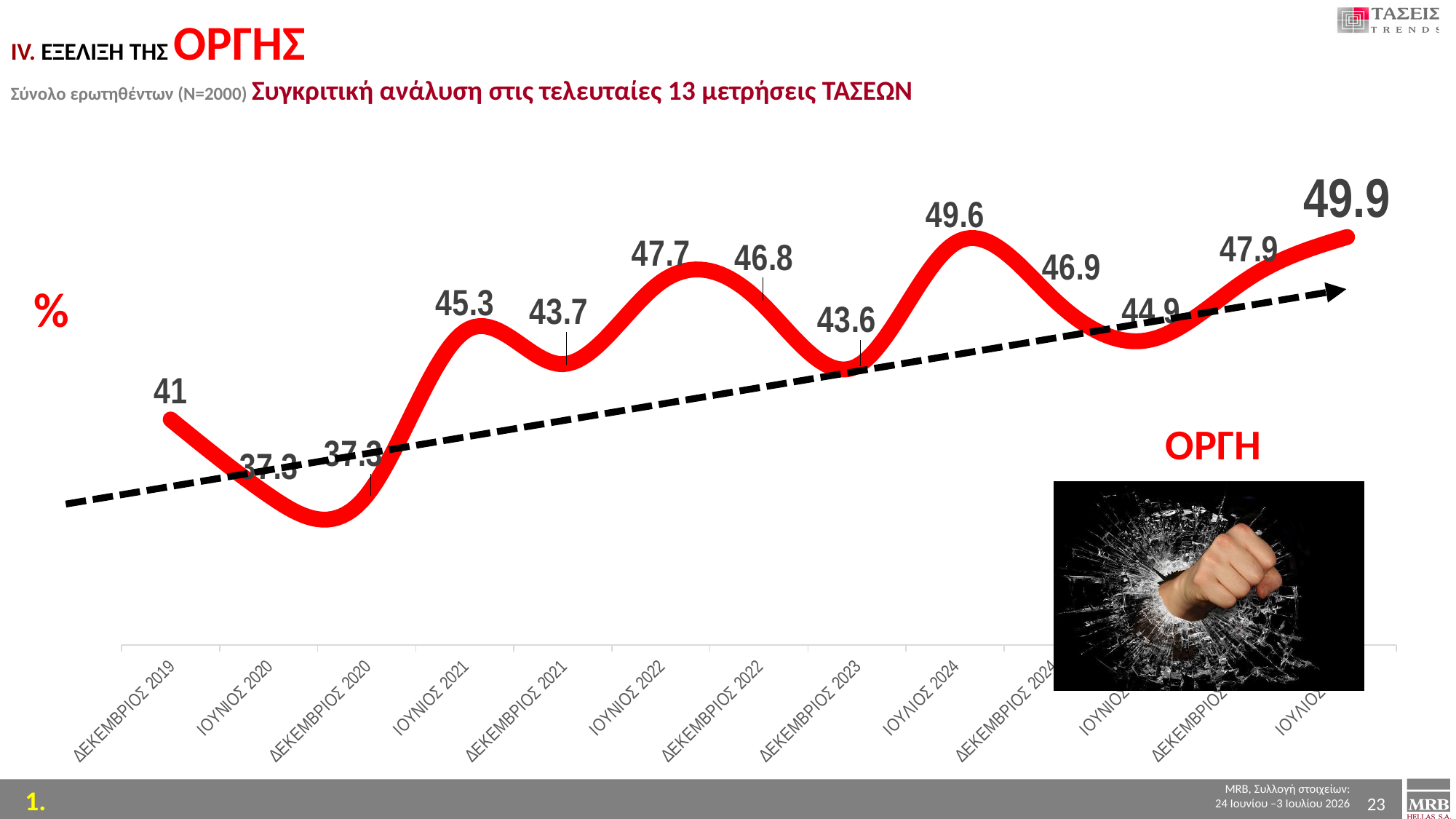
What is the value for ΙΟΥΛΙΟΣ 2024? 49.6 What is the value for ΔΕΚΕΜΒΡΙΟΣ 2023? 43.6 What is the highest value shown on the line? 49.9 How many measurement points are plotted on the chart? 13 What is the value for ΙΟΥΝΙΟΣ 2022? 47.7 What is the value for ΔΕΚΕΜΒΡΙΟΣ 2021? 43.7 Does the overall trend of the values rise or fall from ΔΕΚΕΜΒΡΙΟΣ 2019 to the last measurement? rise What is the difference between the values for ΙΟΥΛΙΟΣ 2024 and ΔΕΚΕΜΒΡΙΟΣ 2023? 6 Which is larger, the value for ΙΟΥΝΙΟΣ 2022 or the value for ΔΕΚΕΜΒΡΙΟΣ 2022? ΙΟΥΝΙΟΣ 2022 What kind of chart is shown on the slide? line chart What is the value for ΔΕΚΕΜΒΡΙΟΣ 2019? 41 What is the value for ΙΟΥΝΙΟΣ 2021? 45.3